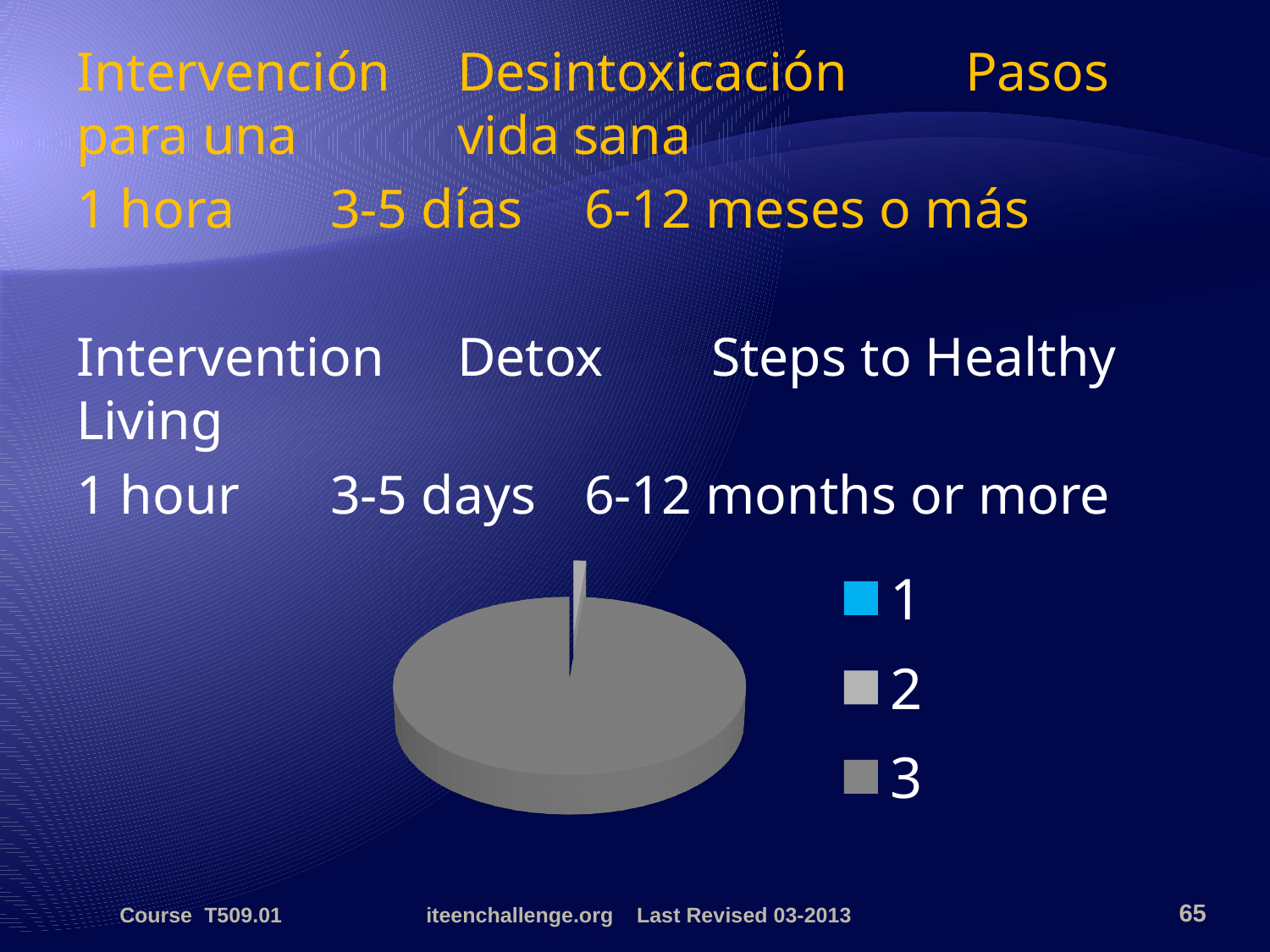
Which slice is larger, 1 or 3? 3 What are the labels listed in the chart's legend? 1, 2, 3 Which legend category has the largest slice of the pie? 3 What colour is legend entry 1 in the pie chart? blue How many entries does the chart's legend list? 3 What kind of chart is shown on the slide? pie chart Which legend category has the smallest slice of the pie? 1 How many slices does the pie chart represent according to the legend? 3